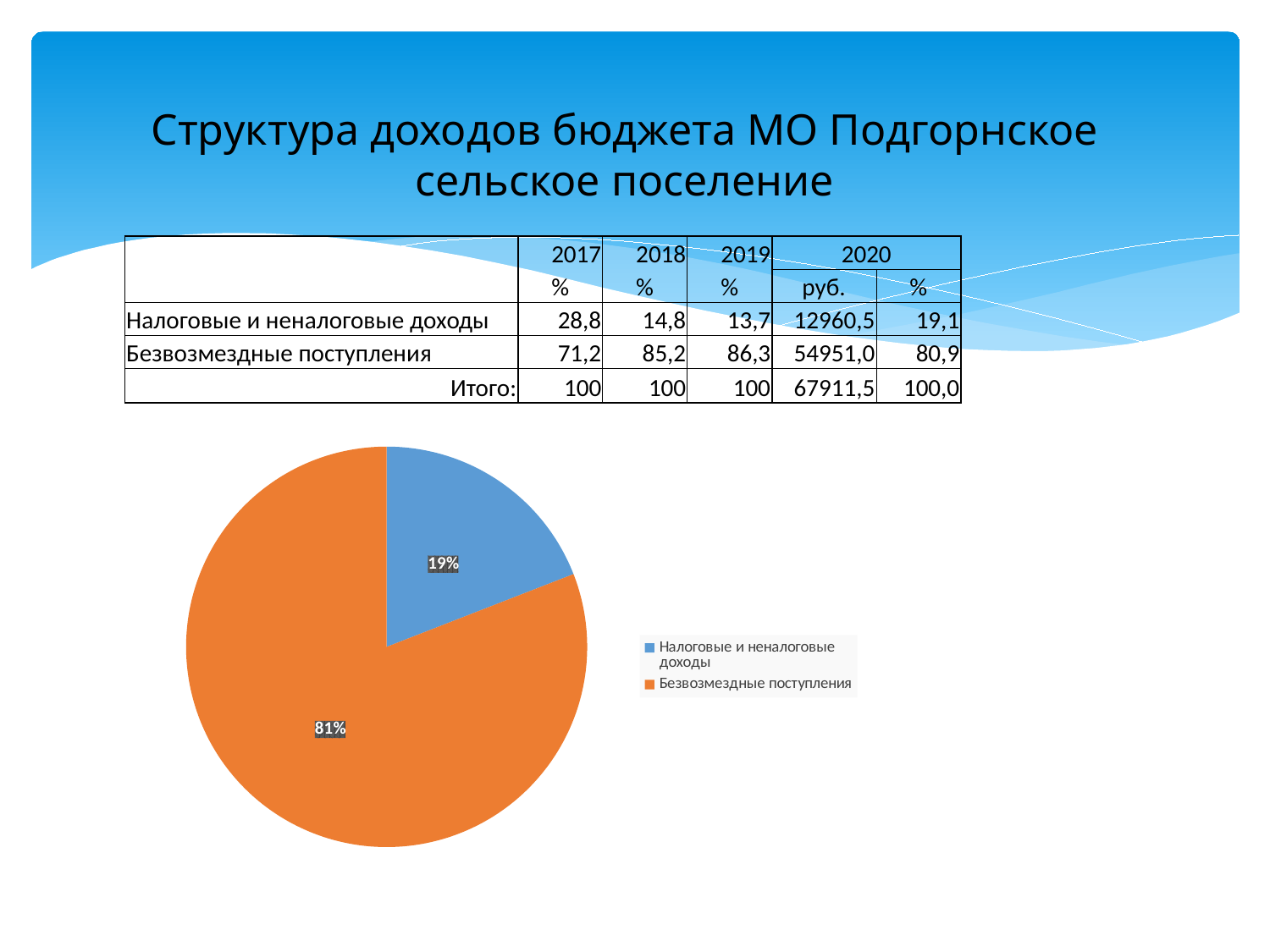
What colour is the Безвозмездные поступления slice in the pie chart? orange What share of the pie chart does Безвозмездные поступления take? 81% What colour is the Налоговые и неналоговые доходы slice in the pie chart? blue What is the difference in percentage points between the Безвозмездные поступления slice and the Налоговые и неналоговые доходы slice? 62 How many entries does the legend of the pie chart list? 2 What share of the pie chart does Налоговые и неналоговые доходы take? 19% Which is larger in the pie chart: Налоговые и неналоговые доходы or Безвозмездные поступления? Безвозмездные поступления Which slice of the pie chart is the largest? Безвозмездные поступления Which slice of the pie chart is the smallest? Налоговые и неналоговые доходы How many slices does the pie chart have? 2 What type of chart is shown on the slide? pie chart